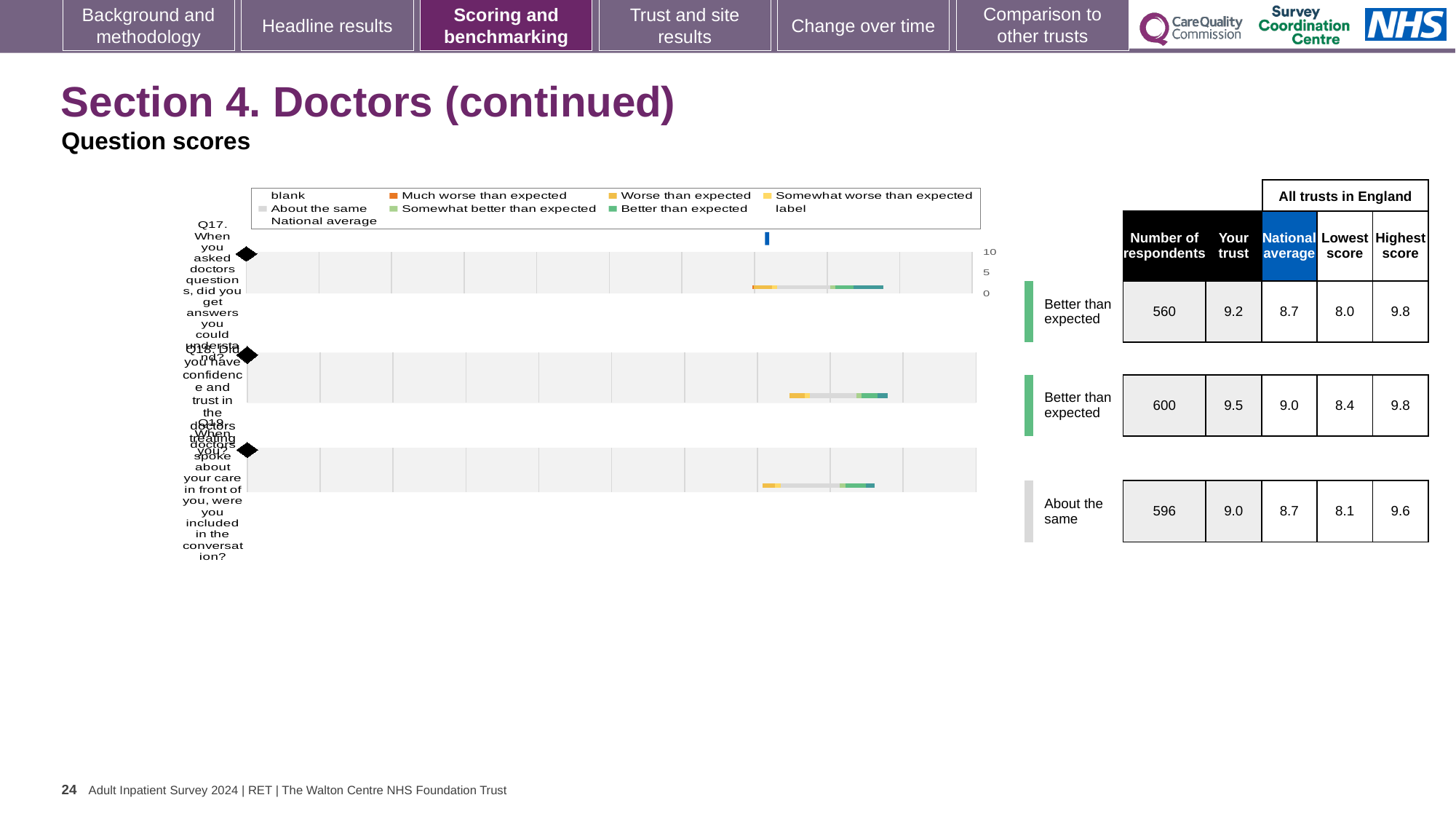
What is the lowest score among all trusts in England for Q18? 8.4 What is the 'Your trust' score for Q17 (When you asked doctors questions, did you get answers you could understand?)? 9.2 For Q18, what is the difference between the 'Your trust' score and the national average? 0.5 How many entries does the chart legend list? 9 Which question has the lowest 'Your trust' score? Q19 What is the national average score for Q18 (Did you have confidence and trust in the doctors treating you?)? 9.0 What benchmark category is shown for Q19? About the same How many respondents answered Q19 (When doctors spoke about your care in front of you, were you included in the conversation?)? 596 Which question has the highest 'Your trust' score? Q18 For Q17, which is larger: the 'Your trust' score or the national average? Your trust What kind of chart is shown on the slide? bar chart How many questions (categories) are plotted in the chart? 3